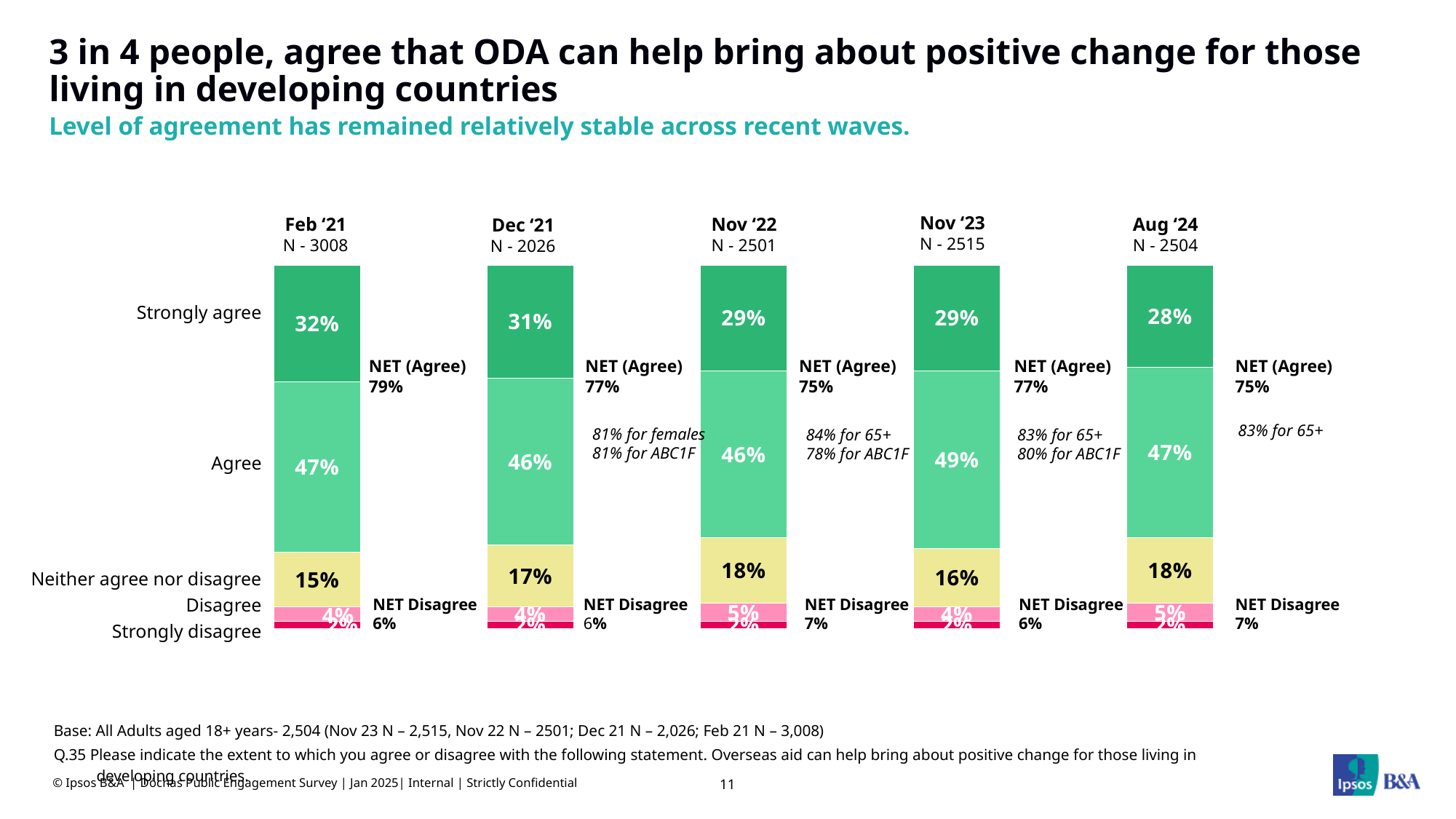
What percentage of respondents strongly agreed in Feb '21? 32% What is the NET (Agree) figure for Aug '24? 75% Which wave has the lowest NET (Agree) figure, Feb '21 or Nov '22? Nov '22 Is the 'Agree' value for Dec '21 larger or smaller than the 'Agree' value for Nov '23? smaller What type of chart is shown on the slide? Stacked bar chart What is the NET Disagree figure for Nov '22? 7% Which wave has the highest 'Strongly agree' percentage? Feb '21 What is the sample size (N) for the Dec '21 wave? 2026 What percentage said 'Neither agree nor disagree' in Nov '22? 18% What is the 'Agree' value for Nov '23? 49% What is the difference between the NET (Agree) figures for Feb '21 and Aug '24? 4 percentage points How many survey waves are shown in the chart? 5